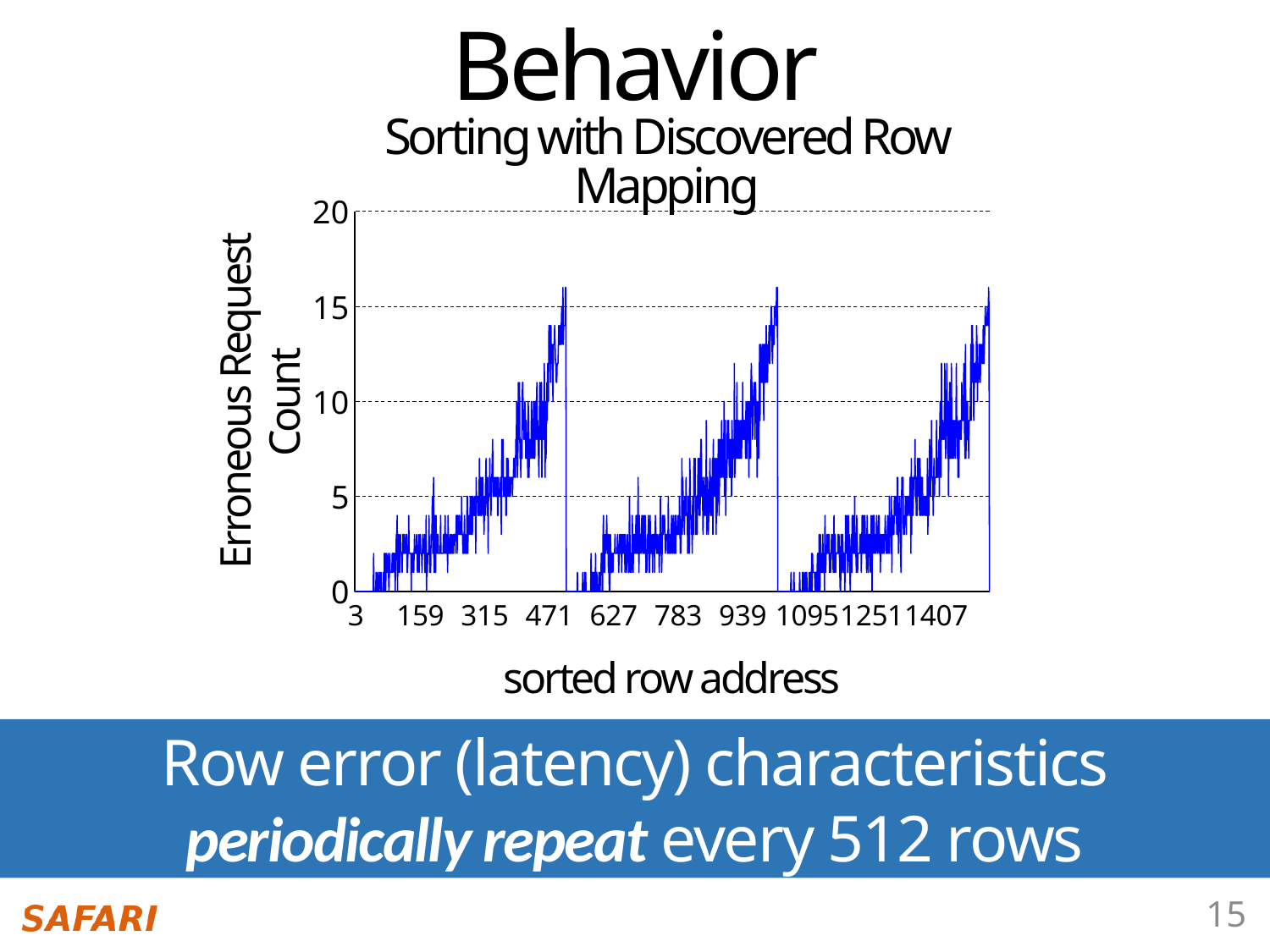
What is the label of the y axis of the chart? Erroneous Request Count Within each repeating segment, do the erroneous request counts rise or fall as the sorted row address increases? rise According to the slide, every how many rows do the row error characteristics periodically repeat? 512 rows Is the peak erroneous request count reached in each repeating segment greater or less than 10? greater Is the erroneous request count at the start of each segment (near sorted row address 3) greater or less than 5? less How many tick labels are printed along the x axis? 10 What is the title of the chart? Sorting with Discovered Row Mapping How many repeating sawtooth segments does the plotted line show across the x axis? 3 What kind of chart is shown on the slide? line chart Is the peak erroneous request count reached in the chart greater or less than 20? less What is the highest tick value shown on the y axis? 20 What is the first tick value shown on the x axis? 3